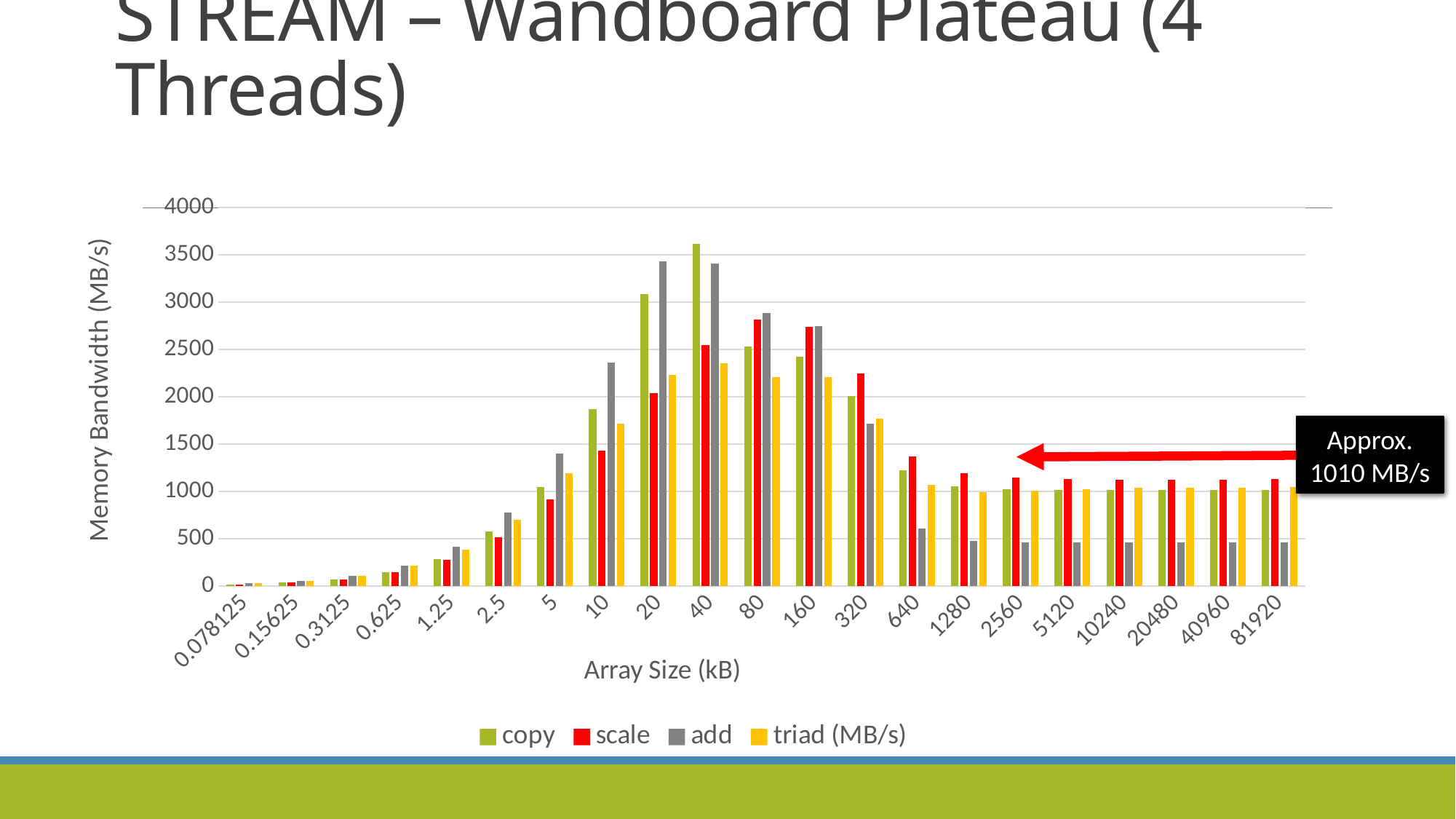
What kind of chart is shown on the slide? Bar chart At which array size does the copy series reach its highest value? 40 At array size 640, which is larger, copy or add? copy At array size 20, which is larger, add or scale? add How many series does the legend list? 4 Is the copy value at array size 40 greater or less than 3000? greater Is the copy value at array size 10 greater or less than 1500? greater Does the copy series rise or fall from array size 40 to array size 640? fall Is the add value at array size 640 greater or less than 1000? less How many array size categories are shown on the x axis? 21 What is the label on the y axis? Memory Bandwidth (MB/s)